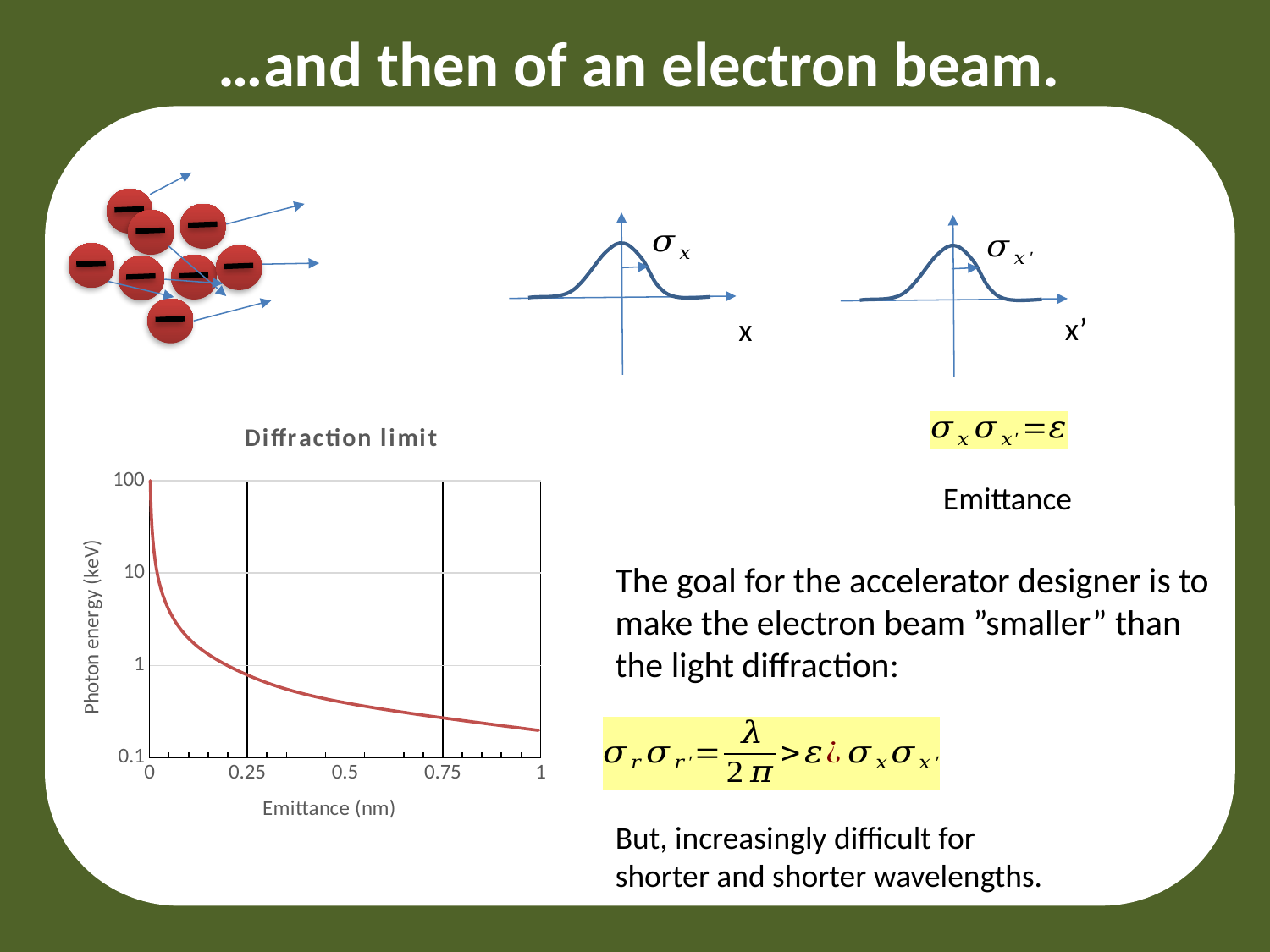
What is the highest value shown on the y axis of the "Diffraction limit" chart? 100 What kind of chart is the "Diffraction limit" chart? line chart What is the title of the chart on the slide? Diffraction limit In the "Diffraction limit" chart, does the photon energy rise or fall as emittance increases? fall In the "Diffraction limit" chart, is the photon energy higher at an emittance of 0.25 nm or at 0.75 nm? 0.25 nm In the "Diffraction limit" chart, is the photon energy at an emittance of 0.75 nm greater or less than 0.1 keV? greater In the "Diffraction limit" chart, is the photon energy at an emittance of 1 nm greater or less than 1 keV? less What is the label of the x axis of the "Diffraction limit" chart? Emittance (nm) In the "Diffraction limit" chart, is the photon energy at an emittance of 0.1 nm greater or less than 1 keV? greater How many labelled tick values are shown on the x axis of the "Diffraction limit" chart? 5